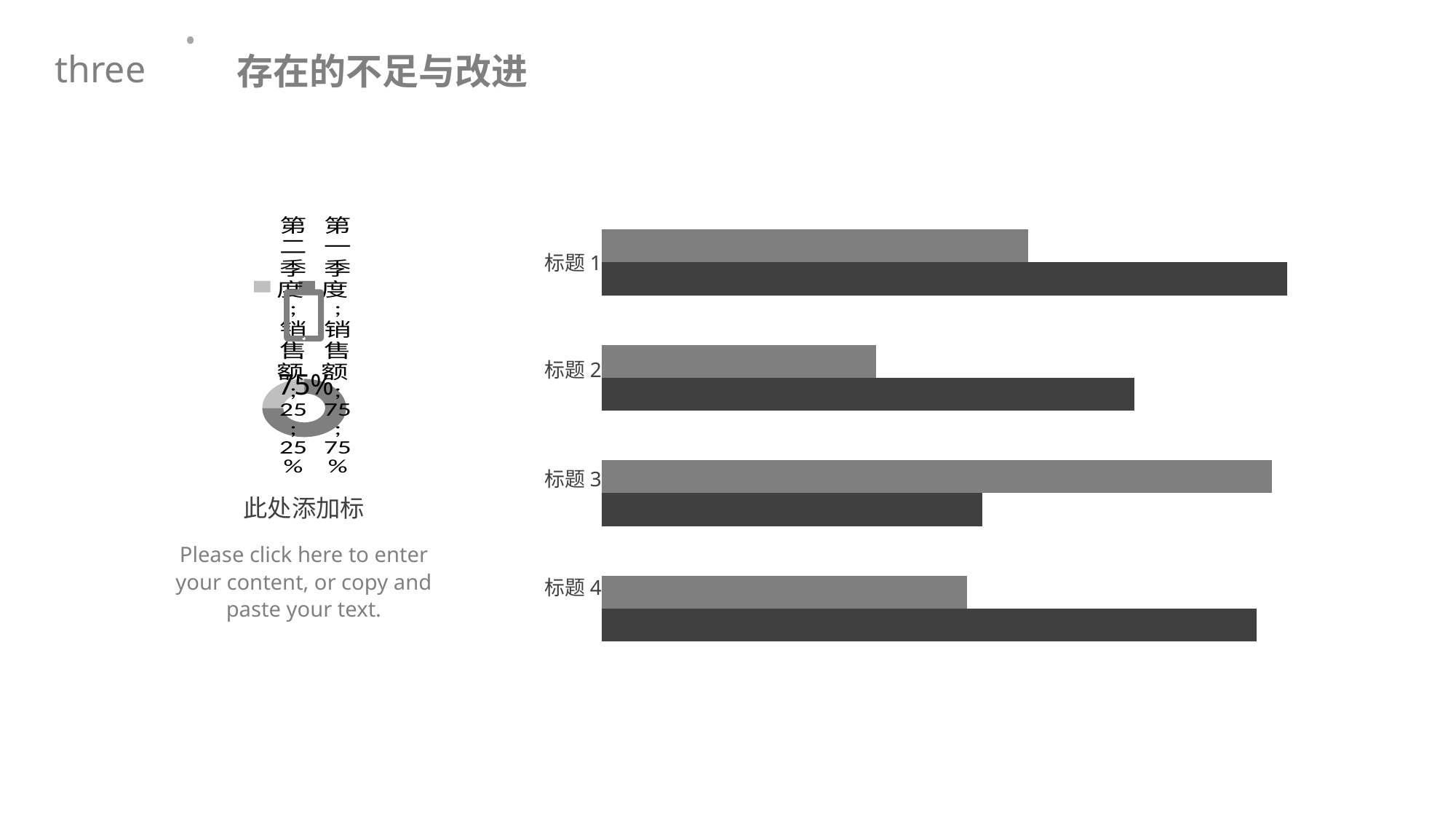
In the bar chart on the right, for 标题 3, which bar is longer, the light gray one or the dark gray one? the light gray one How many categories does the bar chart on the right show? 4 In the doughnut chart on the left, what share is shown for 第一季度? 75% In the bar chart on the right, which category has the longest light gray bar? 标题 3 How many bars are drawn for each category in the bar chart on the right? 2 In the bar chart on the right, is the light gray bar for 标题 1 longer or shorter than the light gray bar for 标题 2? longer In the bar chart on the right, for 标题 1, which bar is longer, the light gray one or the dark gray one? the dark gray one In the doughnut chart on the left, what share is shown for 第二季度? 25% In the bar chart on the right, which category has the shortest dark gray bar? 标题 3 In the bar chart on the right, which category has the shortest light gray bar? 标题 2 What kind of chart is the chart on the right of the slide? bar chart What kind of chart is the small chart on the left of the slide? doughnut chart